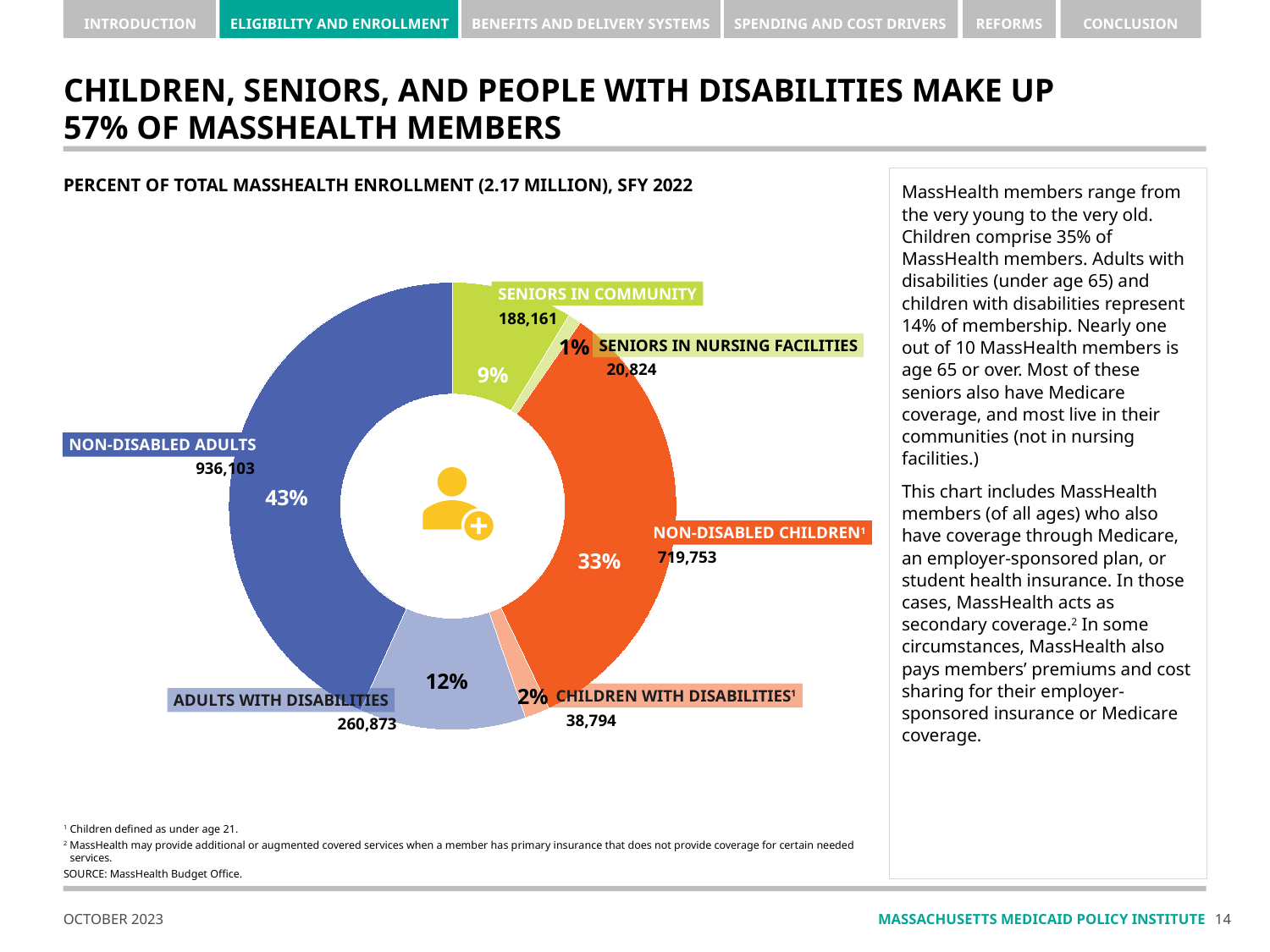
What is the difference in enrollment between Non-Disabled Adults and Non-Disabled Children? 216,350 How many categories does the chart show? 6 Which is larger, the enrollment for Adults with Disabilities or for Seniors in Community? Adults with Disabilities What is the enrollment value for Non-Disabled Adults? 936,103 What is the chart's title? Percent of Total MassHealth Enrollment (2.17 Million), SFY 2022 What percent of total MassHealth enrollment is Non-Disabled Children? 33% Which category has the largest share of enrollment? Non-Disabled Adults What is the enrollment value for Seniors in Nursing Facilities? 20,824 What is the enrollment value for Children with Disabilities? 38,794 Which category has the smallest share of enrollment? Seniors in Nursing Facilities What kind of chart is shown on the slide? Pie chart (donut) What percent of total enrollment is Adults with Disabilities? 12%